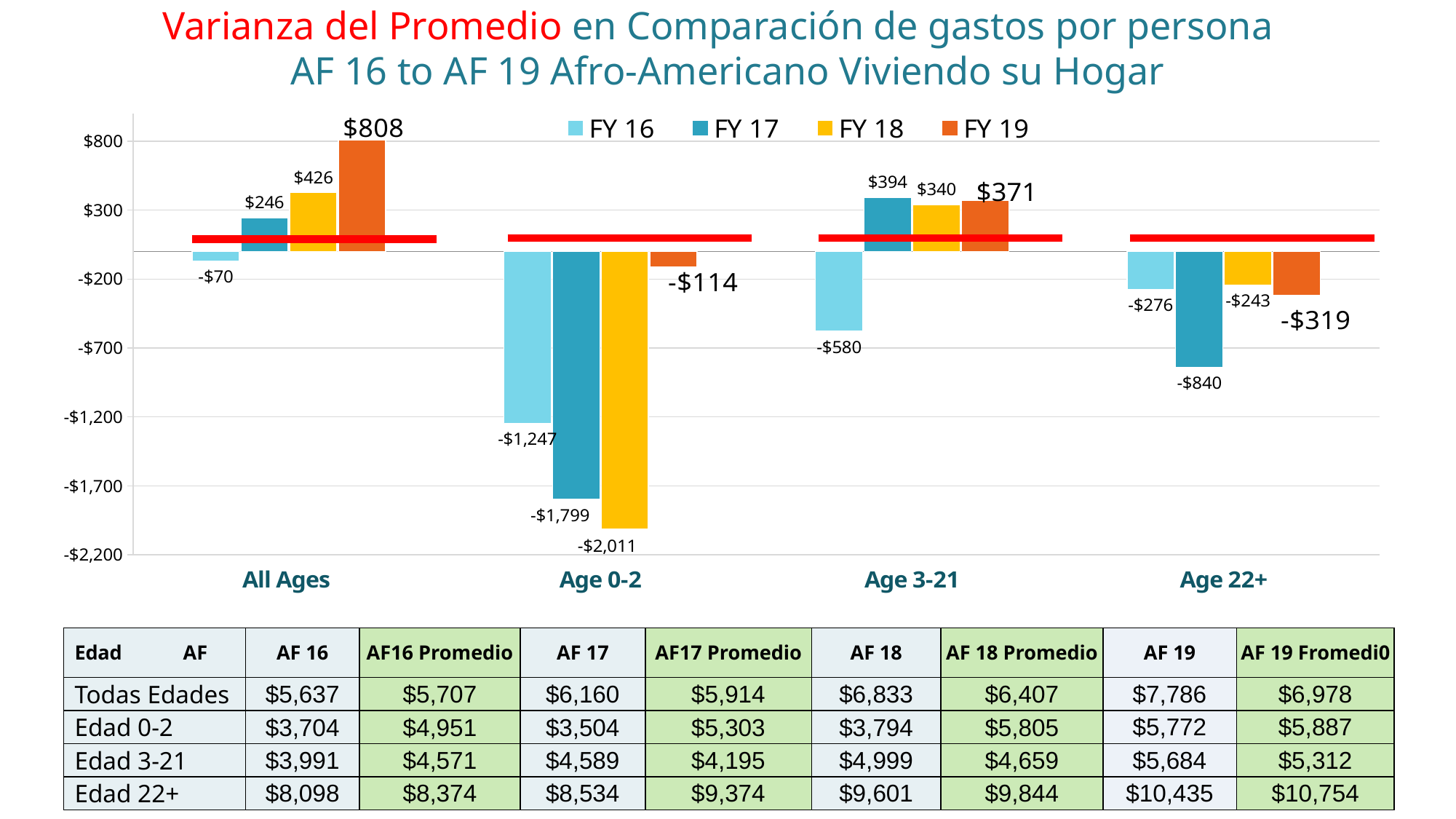
What is the difference between the FY 19 and FY 18 values for All Ages? $382 What is the FY 16 value for Age 3-21? -$580 How many age categories are shown on the x axis of the chart? 4 Which category has the highest FY 19 value? All Ages What is the FY 17 value for Age 22+? -$840 Which legend entry is shown in orange? FY 19 Which category has the lowest FY 18 value? Age 0-2 How many series does the chart legend list? 4 What type of chart is shown on the slide? Bar chart Which is larger for Age 3-21, the FY 17 value or the FY 18 value? FY 17 What is the FY 19 value for All Ages? $808 What is the FY 18 value for Age 0-2? -$2,011